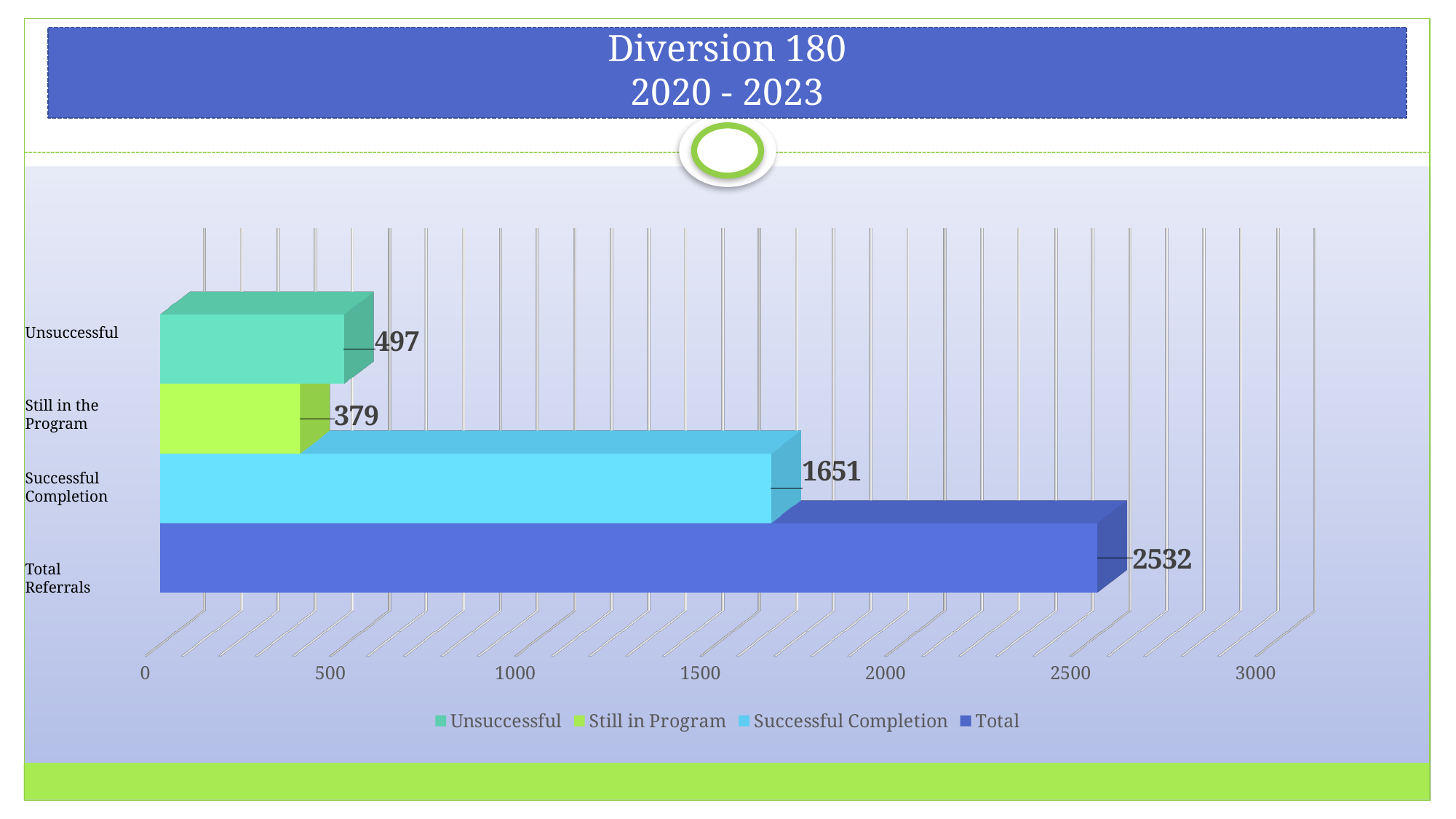
Which category has the lowest value? Still in the Program Which is larger, Unsuccessful or Still in the Program? Unsuccessful How many categories are shown on the chart? 4 What kind of chart is shown on the slide? Bar chart What is the value for Still in the Program? 379 What is the title of the slide? Diversion 180 2020 - 2023 How many series does the legend list? 4 Which category has the highest value? Total Referrals What is the value for Successful Completion? 1651 What is the value for Unsuccessful? 497 What is the value for Total Referrals? 2532 What is the difference between Successful Completion and Unsuccessful? 1154